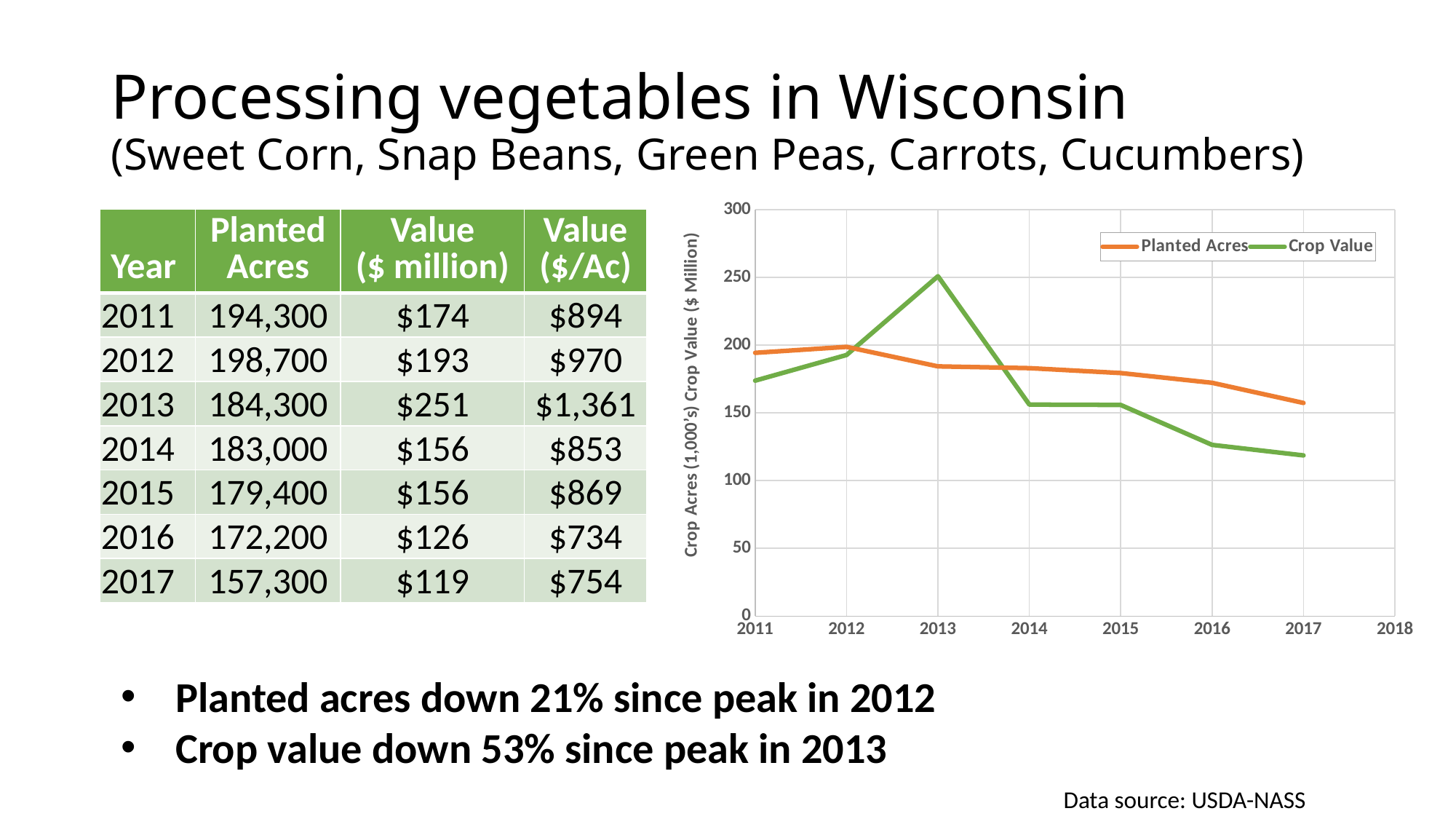
In 2013, which line is higher, Planted Acres or Crop Value? Crop Value What kind of chart is shown on the right of the slide? line chart Is the Crop Value for 2017 greater or less than 150? less In which year is the Crop Value line at its lowest? 2017 In 2011, which line is higher, Planted Acres or Crop Value? Planted Acres What are the two series named in the chart's legend? Planted Acres and Crop Value How many series does the chart's legend list? 2 How many years are plotted for each series in the chart? 7 Is the Crop Value for 2013 greater or less than 200? greater In which year does the Crop Value line reach its highest point? 2013 What is the Crop Value ($ million) for 2013, as printed in the table? $251 Does the Planted Acres line rise or fall from 2012 to 2017? fall